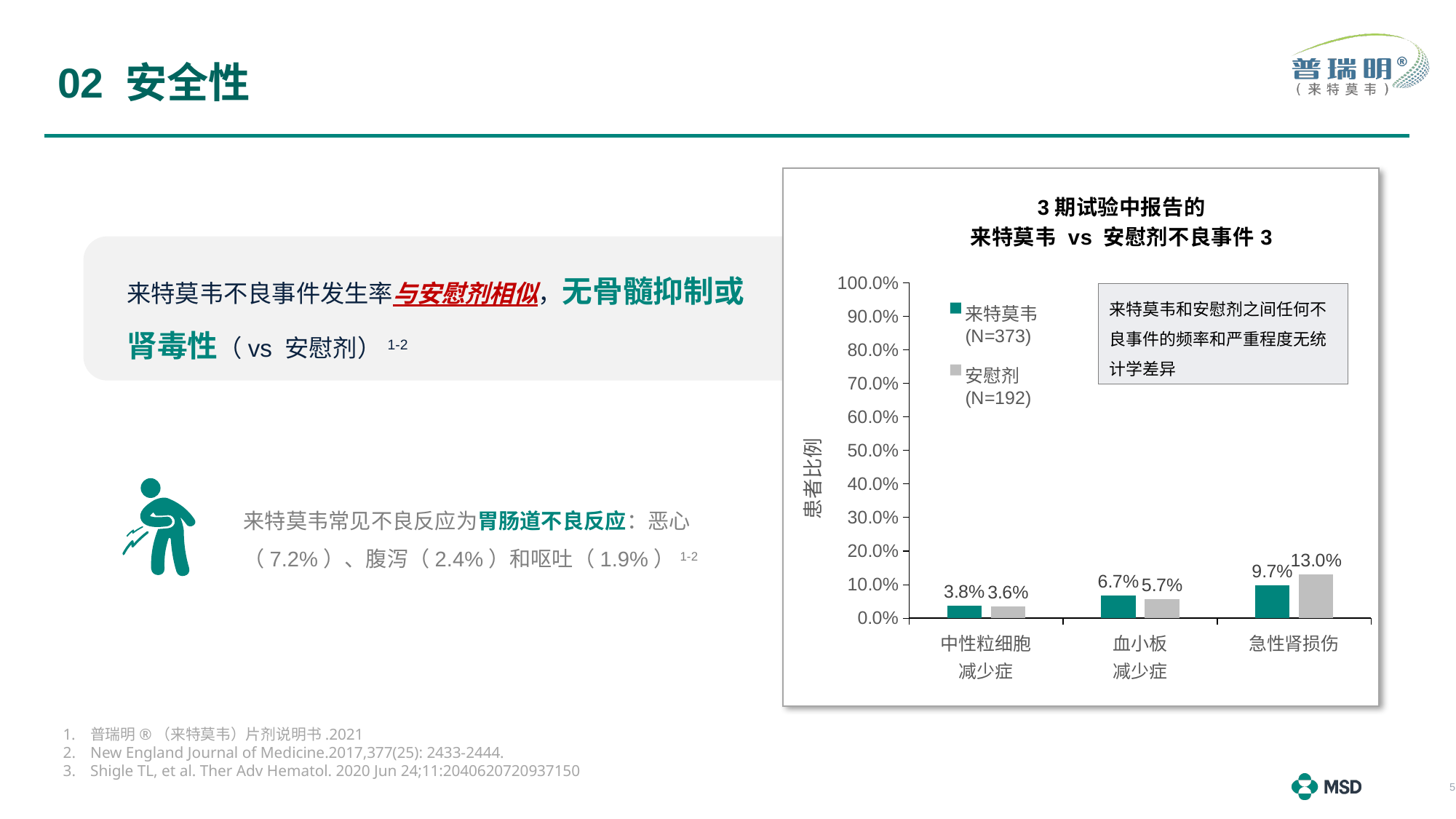
这张幻灯片上的图表是什么类型的图表？ 柱状图（条形图） 图表中来特莫韦组的样本量（N）是多少？ 373 图表中来特莫韦组的中性粒细胞减少症发生率是多少？ 3.8% 图表中安慰剂组的急性肾损伤发生率是多少？ 13.0% 图表中安慰剂组的血小板减少症发生率是多少？ 5.7% 图表中来特莫韦组的急性肾损伤发生率是高于还是低于10.0%？ 低于 图表中血小板减少症的发生率，来特莫韦组和安慰剂组哪个更高？ 来特莫韦 图表中来特莫韦组哪一类不良事件的发生率最高？ 急性肾损伤 图表的横轴上共有几类不良事件？ 3 图表中安慰剂组哪一类不良事件的发生率最低？ 中性粒细胞减少症 图表的图例中列出了几个系列？ 2 图表中急性肾损伤的发生率，安慰剂组比来特莫韦组高多少个百分点？ 3.3%